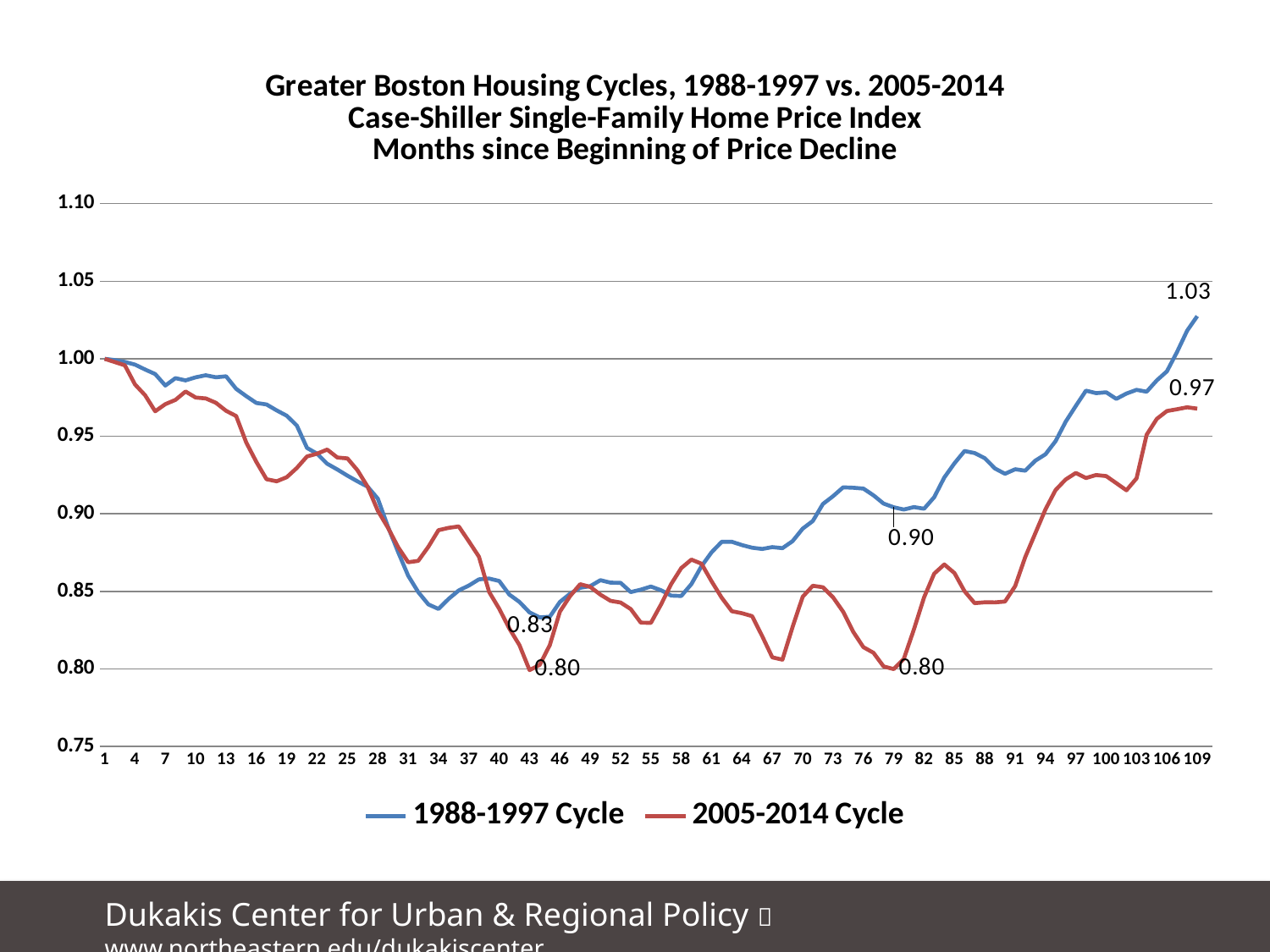
At month 79, which series has the higher value, the 1988-1997 Cycle or the 2005-2014 Cycle? 1988-1997 Cycle What type of chart is shown on the slide? line chart Does the 1988-1997 Cycle rise or fall between month 79 and month 109? rise What is the lowest labeled value of the 2005-2014 Cycle? 0.80 What is the final labeled value of the 1988-1997 Cycle at month 109? 1.03 What is the labeled value of the 1988-1997 Cycle at month 79? 0.90 What is the difference between the final labeled values of the 1988-1997 Cycle (1.03) and the 2005-2014 Cycle (0.97)? 0.06 What is the lowest labeled value of the 1988-1997 Cycle? 0.83 Is the value of the 1988-1997 Cycle at month 85 greater or less than 0.90? greater What is the final labeled value of the 2005-2014 Cycle at month 109? 0.97 How many series does the legend list? 2 Is the value of the 2005-2014 Cycle at month 67 greater or less than 0.85? less